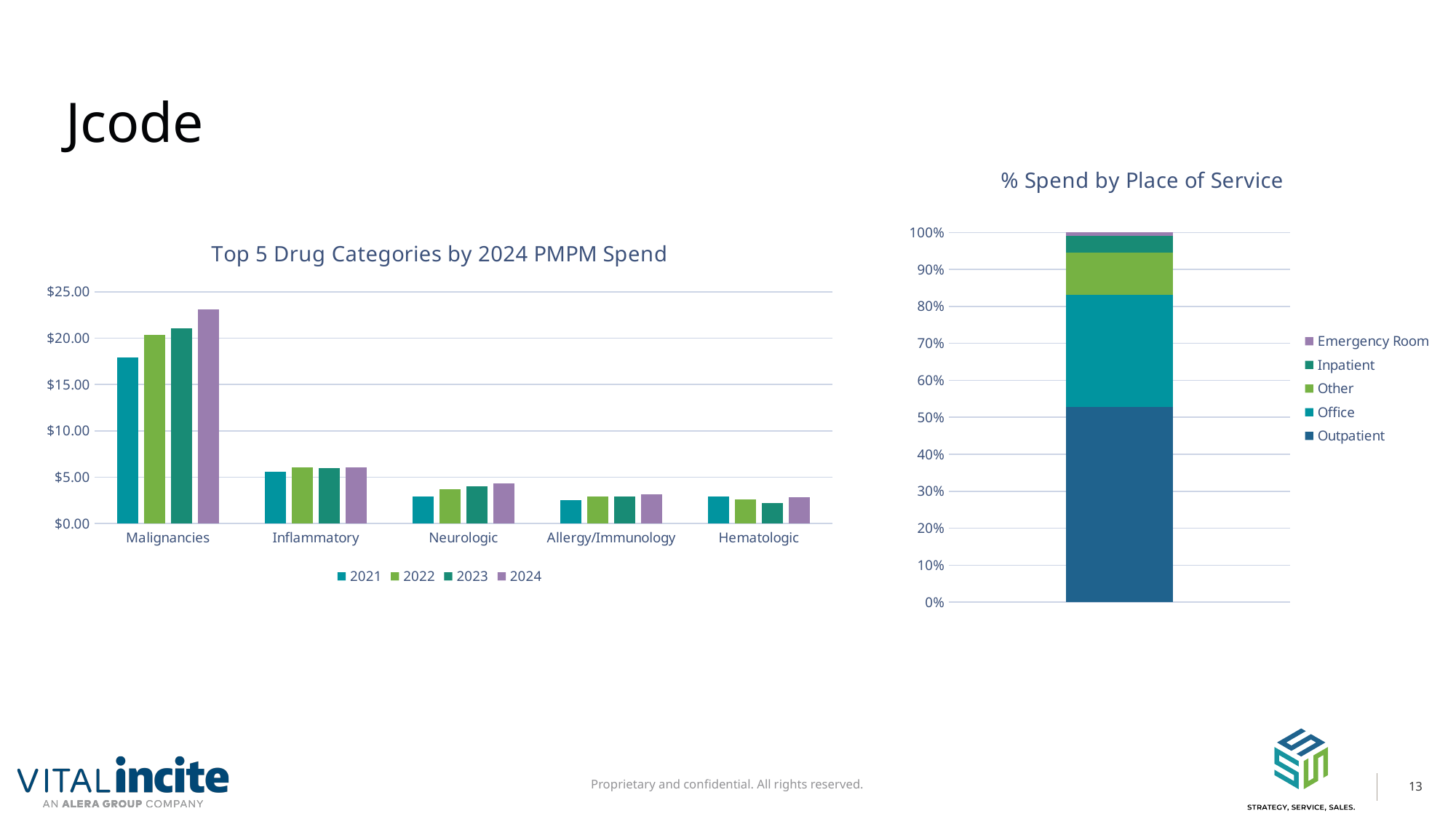
On the 'Top 5 Drug Categories by 2024 PMPM Spend' chart, is the 2024 value for Malignancies greater or less than $20.00? greater On the 'Top 5 Drug Categories by 2024 PMPM Spend' chart, which is larger for Malignancies: the 2021 value or the 2024 value? 2024 On the 'Top 5 Drug Categories by 2024 PMPM Spend' chart, is the 2021 value for Neurologic greater or less than $5.00? less On the '% Spend by Place of Service' chart, which place of service has the largest share of spend? Outpatient How many series does the legend of the 'Top 5 Drug Categories by 2024 PMPM Spend' chart list? 4 How many drug categories are shown on the 'Top 5 Drug Categories by 2024 PMPM Spend' chart? 5 What kind of chart is the 'Top 5 Drug Categories by 2024 PMPM Spend' chart? bar chart On the '% Spend by Place of Service' chart, is the Outpatient share greater or less than 50%? greater How many series does the legend of the '% Spend by Place of Service' chart list? 5 On the 'Top 5 Drug Categories by 2024 PMPM Spend' chart, which category has the highest 2024 spend? Malignancies What kind of chart is the '% Spend by Place of Service' chart? stacked bar chart On the 'Top 5 Drug Categories by 2024 PMPM Spend' chart, do the Malignancies values rise or fall from 2021 to 2024? rise